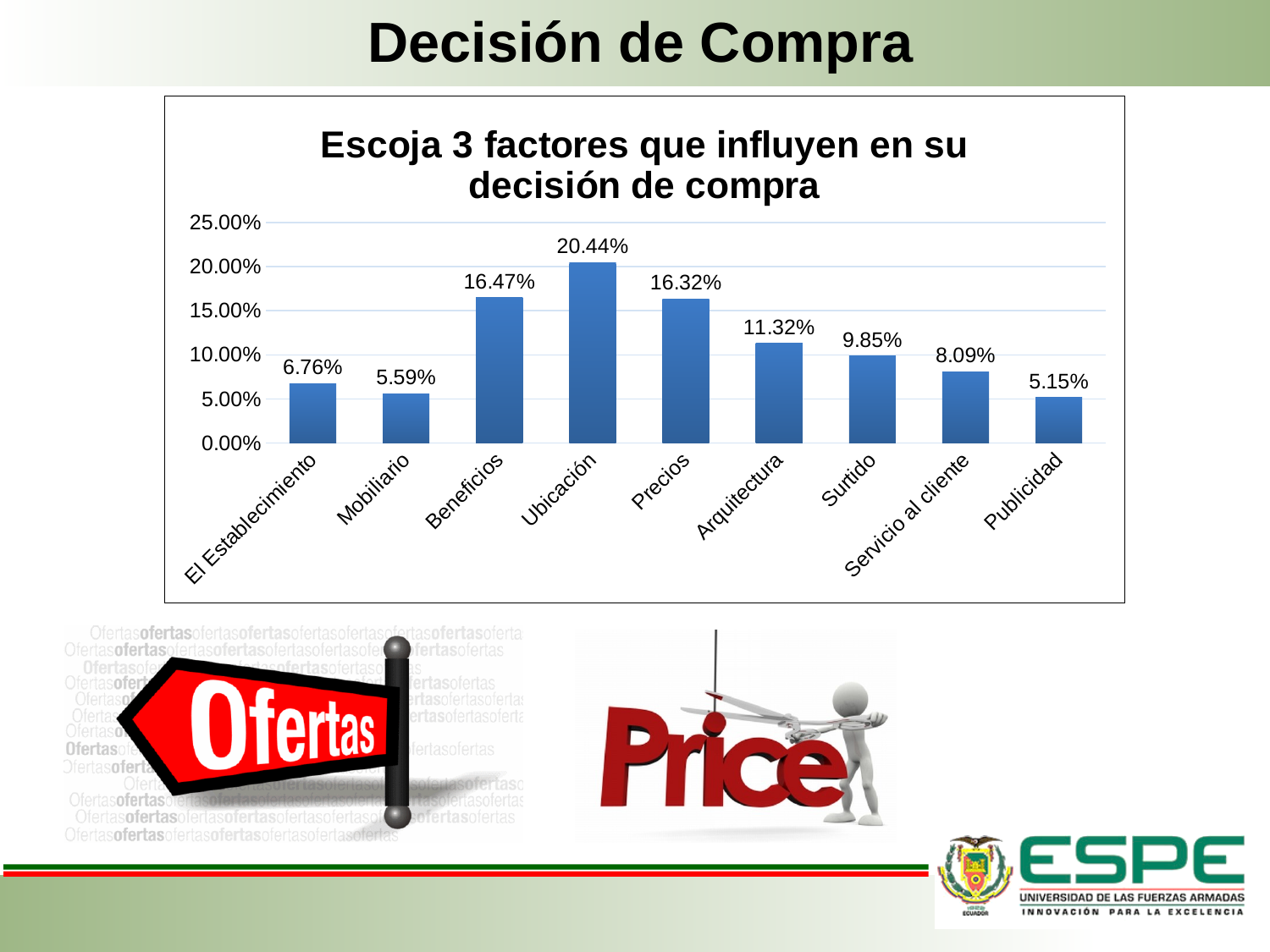
Which category has the highest value? Ubicación What is the title of the chart? Escoja 3 factores que influyen en su decisión de compra What kind of chart is shown on the slide? Bar chart What is the value for Mobiliario? 5.59% How many categories are shown on the x axis? 9 What is the value for Ubicación? 20.44% What is the difference between the values for Ubicación and Precios? 4.12% Which category has the lowest value? Publicidad What is the difference between the values for El Establecimiento and Publicidad? 1.61% Which is larger, the value for Arquitectura or the value for Surtido? Arquitectura What is the value for Servicio al cliente? 8.09% Is the value for Beneficios greater or less than 15.00%? greater